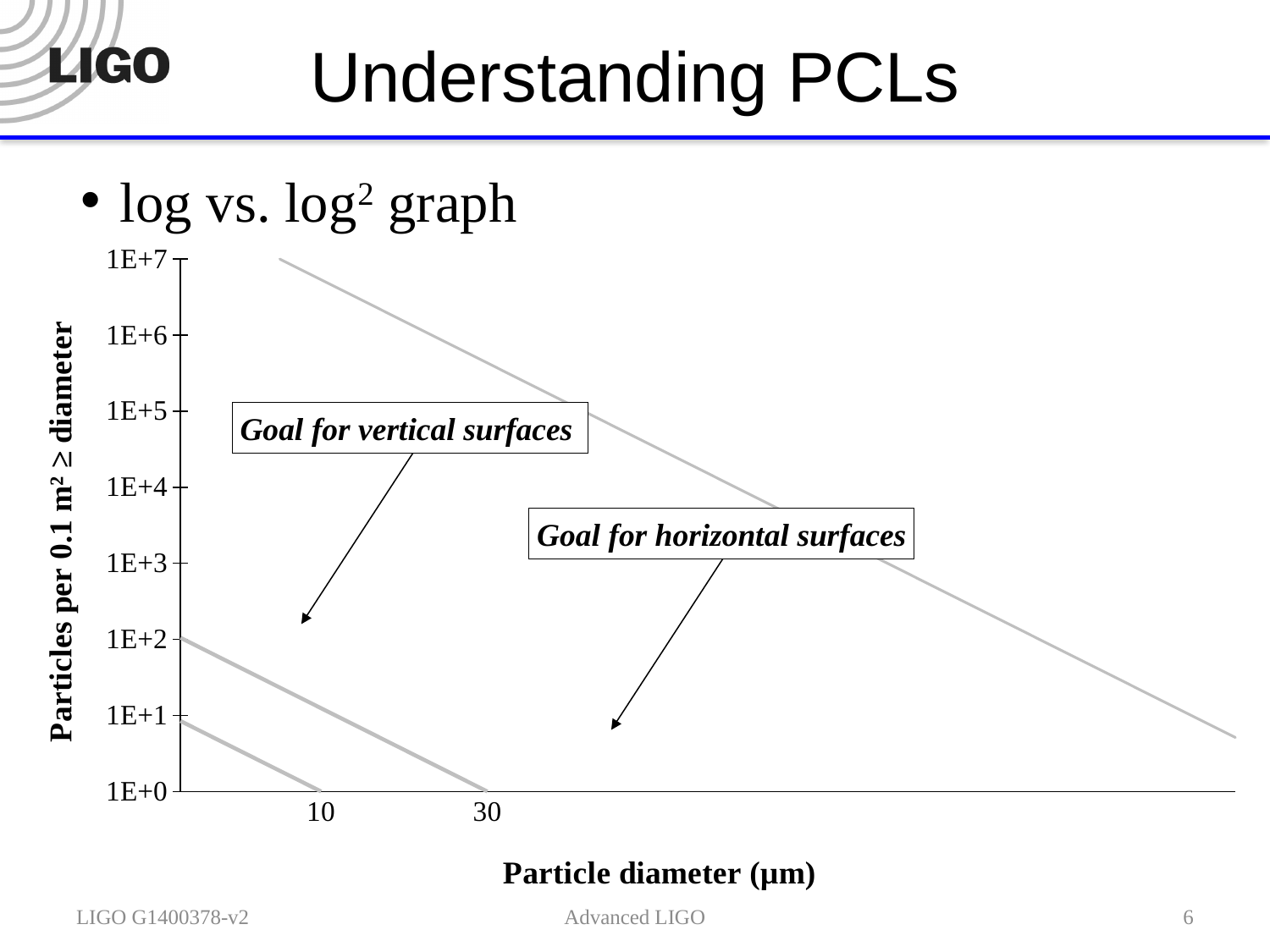
How many tick labels are shown on the x axis? 2 What is the highest value shown on the y axis? 1E+7 What kind of chart is shown on the slide? line chart At what particle diameter does the upper 'Goal for vertical surfaces' line reach 1E+0? 30 At a particle diameter of 10 µm, is the value of the upper 'Goal for vertical surfaces' line greater or less than 1E+2? less How many lines are plotted on the chart? 3 What is the label of the x axis of the chart? Particle diameter (µm) What is the label of the y axis of the chart? Particles per 0.1 m² ≥ diameter At what particle diameter does the lower 'Goal for vertical surfaces' line reach 1E+0? 10 At a particle diameter of 30 µm, is the value of the 'Goal for horizontal surfaces' line greater or less than 1E+4? greater Which goal line lies higher on the chart, the goal for horizontal surfaces or the goal for vertical surfaces? Goal for horizontal surfaces Do the plotted lines rise or fall as particle diameter increases along the x axis? fall